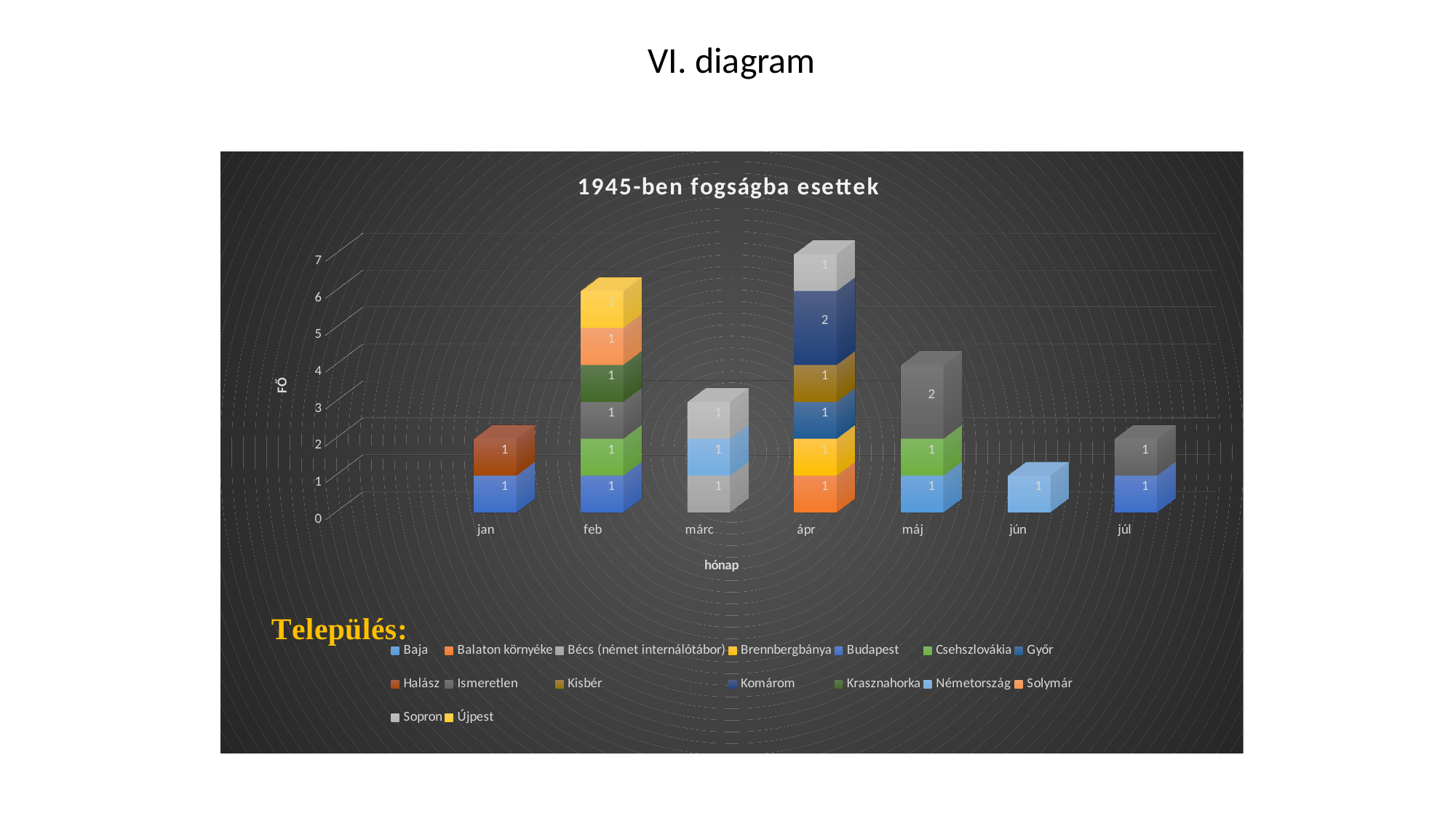
Which month has the highest total stacked bar? ápr What is the total height of the stacked bar for ápr? 7 What is the total height of the stacked bar for jan? 2 How many months are shown on the x axis of the chart? 7 What is the difference between the total for feb and the total for márc? 3 How many series (settlements) does the legend list? 16 What kind of chart is shown on the slide? stacked bar chart What is the total height of the stacked bar for feb? 6 What is the title of the chart? 1945-ben fogságba esettek Which month has the lowest total stacked bar? jún Which month has a larger total, feb or máj? feb